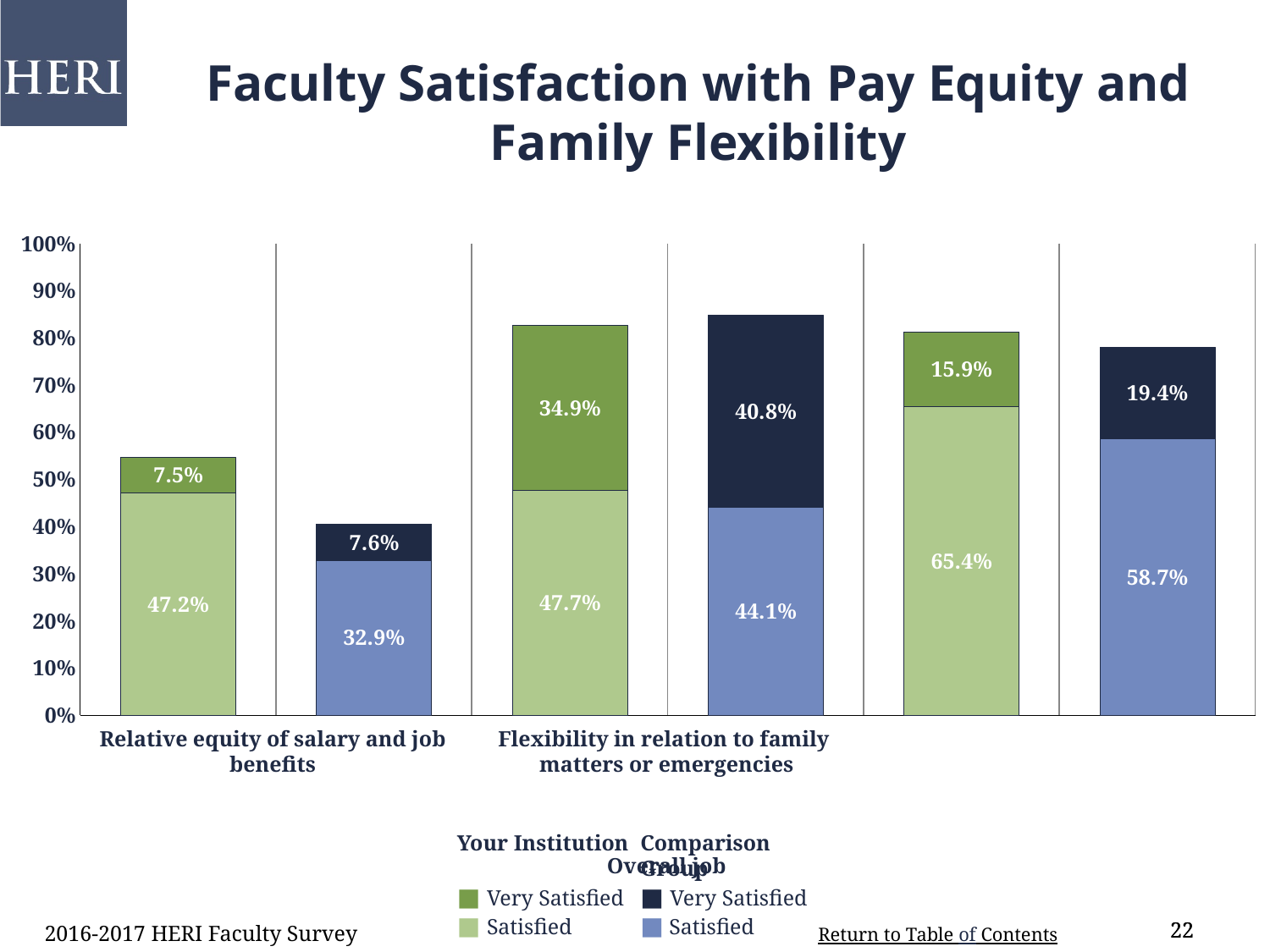
How many entries does the legend list? 4 Which colour represents Very Satisfied for Your Institution? Dark green What percentage of the Comparison Group is Satisfied with relative equity of salary and job benefits? 32.9% What is the title of the slide's chart? Faculty Satisfaction with Pay Equity and Family Flexibility What is the combined Satisfied and Very Satisfied percentage for the Comparison Group on flexibility in relation to family matters or emergencies? 84.9% What percentage of faculty at Your Institution are Satisfied with relative equity of salary and job benefits? 47.2% What is the difference between the Very Satisfied percentages for Your Institution and the Comparison Group on flexibility in relation to family matters or emergencies? 5.9% What is the combined Satisfied and Very Satisfied percentage for Your Institution on relative equity of salary and job benefits? 54.7% For relative equity of salary and job benefits, which has the larger Satisfied percentage: Your Institution or the Comparison Group? Your Institution Is the total stacked bar for the Comparison Group on relative equity of salary and job benefits greater or less than 50%? less What percentage of the Comparison Group is Very Satisfied with flexibility in relation to family matters or emergencies? 40.8% What kind of chart is shown on the slide? Stacked bar chart